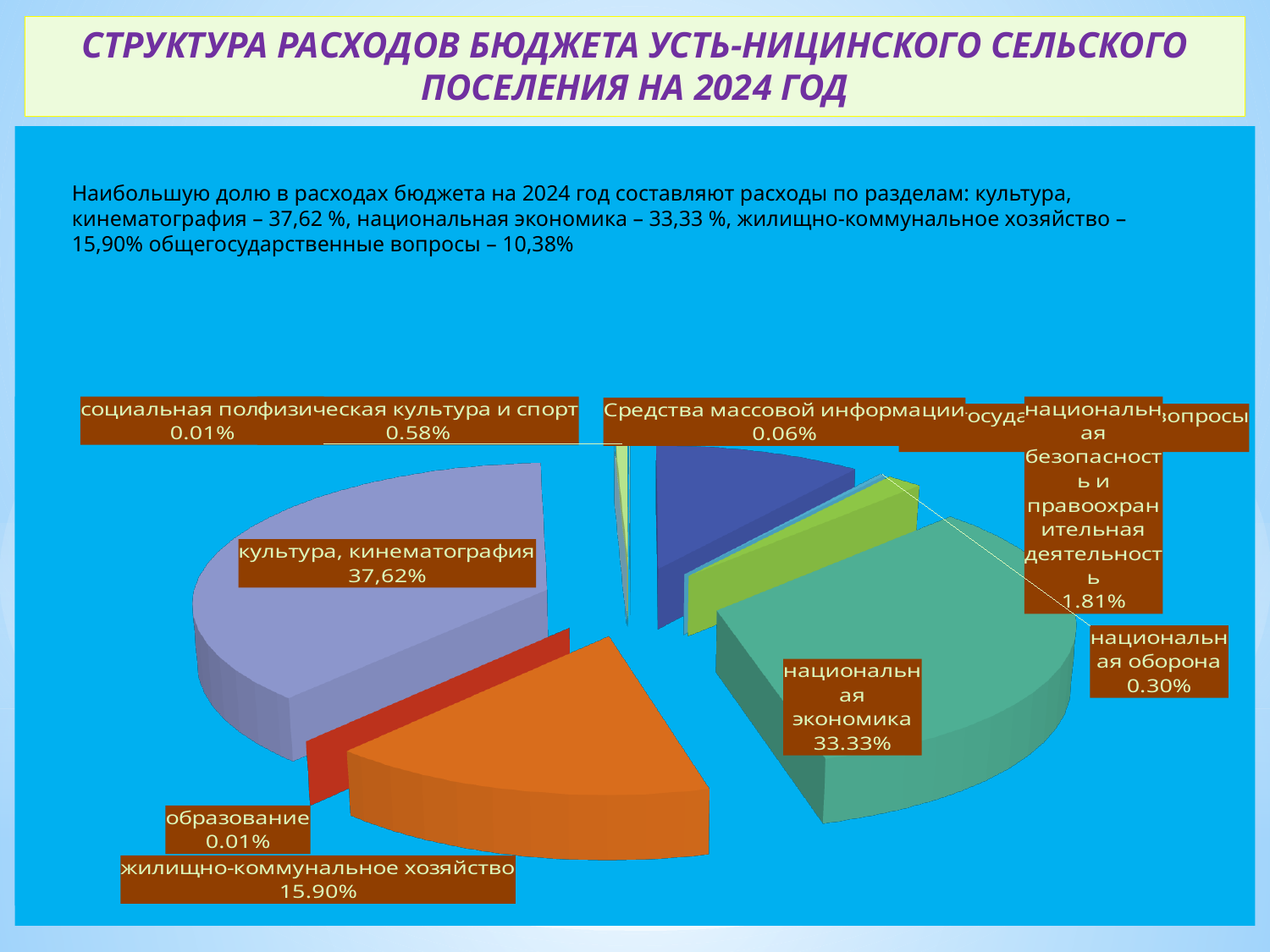
What is the difference between the shares for национальная экономика and жилищно-коммунальное хозяйство? 17.43% What share is shown for национальная оборона? 0.30% What kind of chart is shown on the slide? pie chart What share is shown for образование? 0.01% Which is larger: the share for национальная безопасность и правоохранительная деятельность or for национальная оборона? национальная безопасность и правоохранительная деятельность What share of the budget expenditure is labelled for культура, кинематография? 37,62% Which category has the largest share of the pie? культура, кинематография What share is shown for Средства массовой информации? 0.06% What share is shown for физическая культура и спорт? 0.58% What share is shown for жилищно-коммунальное хозяйство? 15.90% What share is shown for национальная экономика? 33.33% What share is shown for национальная безопасность и правоохранительная деятельность? 1.81%